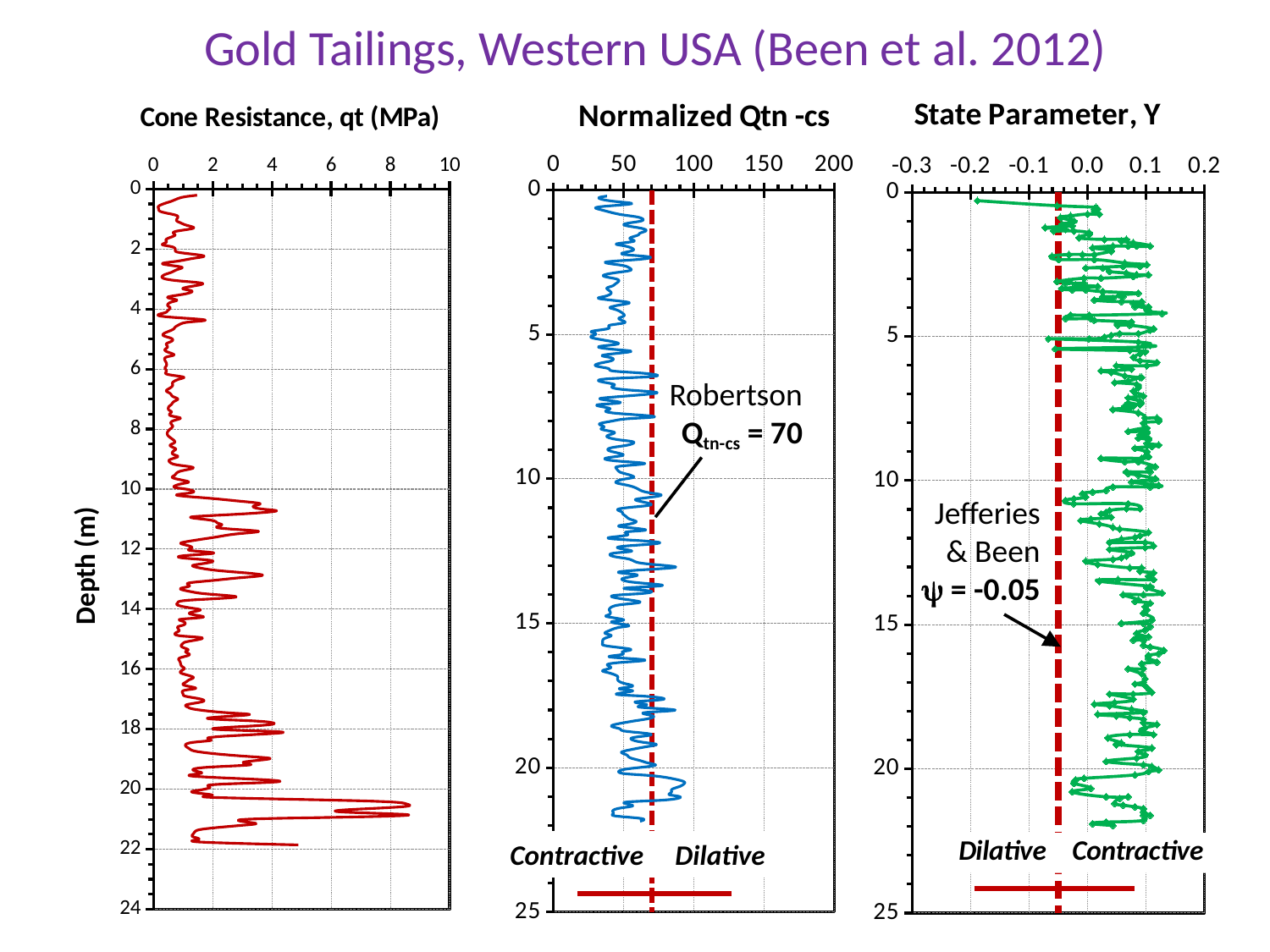
What is the maximum value shown on the x axis of the Cone Resistance chart? 10 On the Normalized Qtn-cs chart, is the value at a depth of 5 m greater or less than 100? less How many charts are shown on the slide? 3 On the Normalized Qtn-cs chart, which side of the dashed reference line is labelled Dilative? right On the State Parameter chart, is the value at the shallowest point (about 0.5 m depth) greater or less than -0.1? less On the State Parameter chart, is the value at a depth of 10 m greater or less than 0.0? greater What is the title of the slide? Gold Tailings, Western USA (Been et al. 2012) On the Normalized Qtn-cs chart, what value does the dashed red Robertson reference line mark? Qtn-cs = 70 On the State Parameter chart, what value does the dashed red Jefferies & Been reference line mark? ψ = -0.05 What kind of chart is the Cone Resistance, qt (MPa) chart? line chart